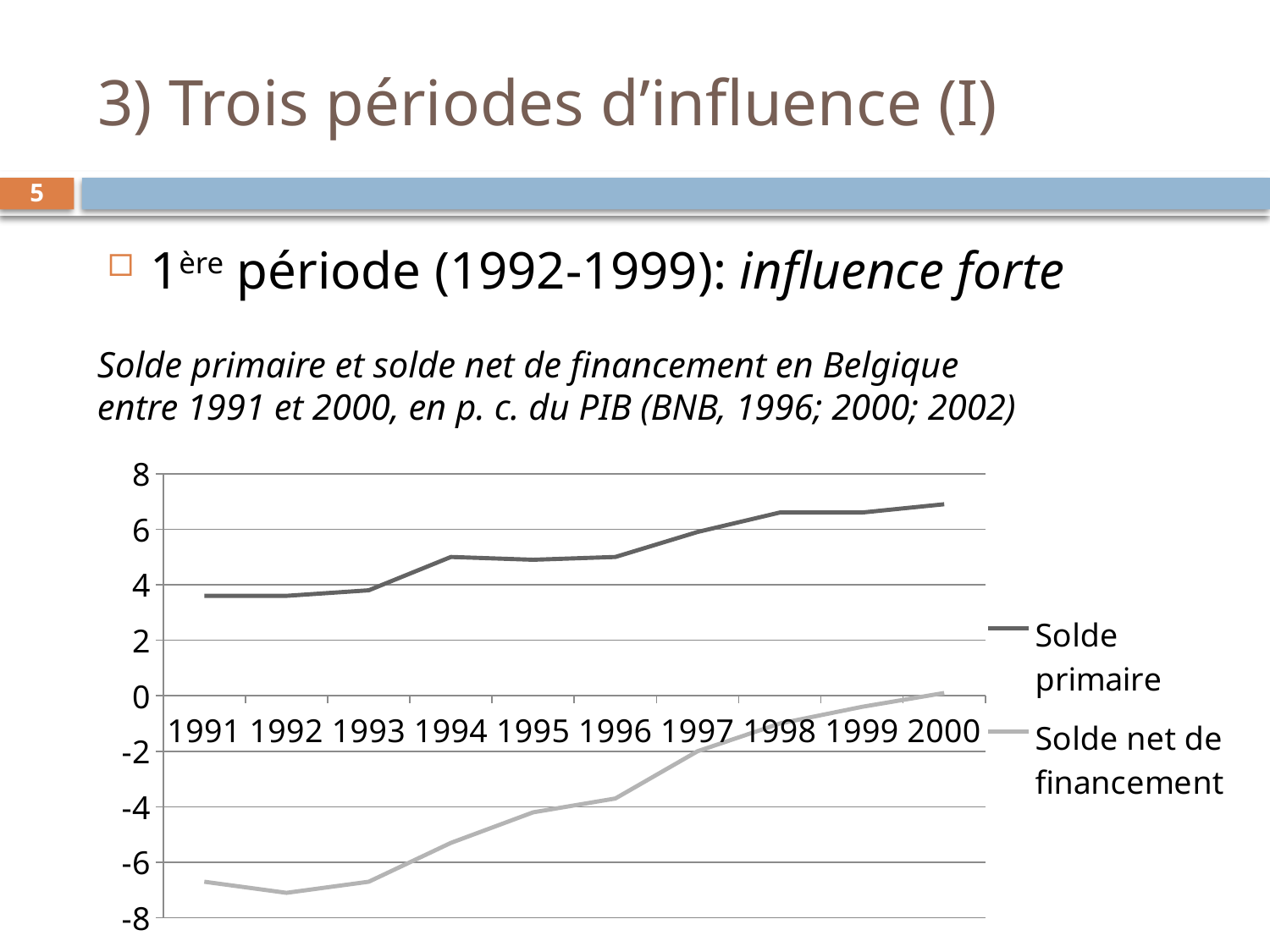
In which year is the Solde primaire value highest? 2000 Does the Solde net de financement line rise or fall from 1993 to 2000? rise Is the Solde net de financement value for 1996 greater or less than -4? greater In which year is the Solde net de financement value lowest? 1992 Is the Solde net de financement value for 1992 greater or less than -6? less Is the Solde primaire value for 1998 greater or less than 6? greater Which series does the lighter grey line represent? Solde net de financement How many years are plotted along the x axis? 10 What kind of chart is shown on the slide? line chart In 1995, which series has the larger value, Solde primaire or Solde net de financement? Solde primaire How many series does the legend list? 2